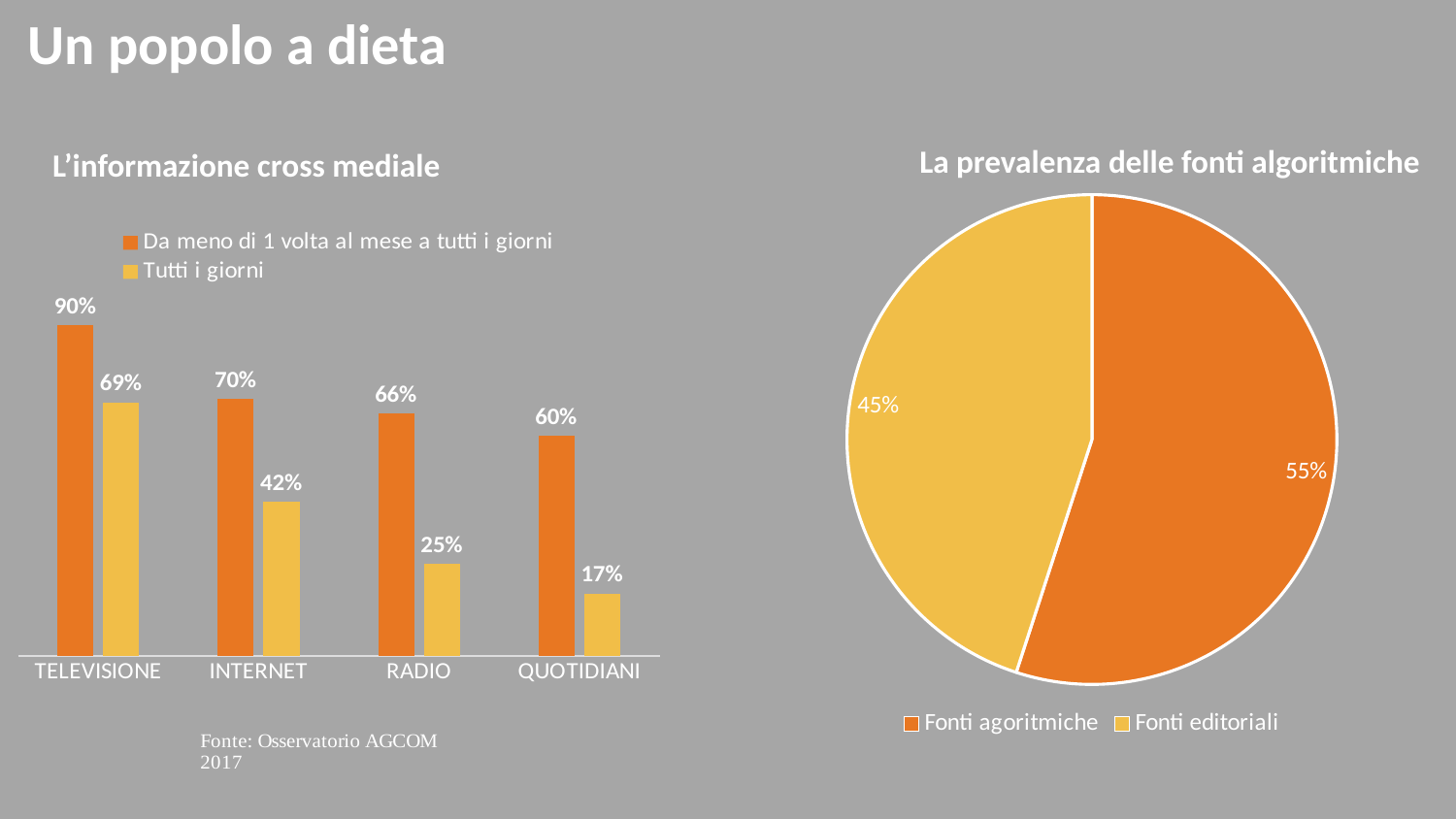
In the chart 'La prevalenza delle fonti algoritmiche', what share of the pie is 'Fonti agoritmiche'? 55% In the chart 'L'informazione cross mediale', which category has the lowest value in the series 'Tutti i giorni'? QUOTIDIANI In the chart 'L'informazione cross mediale', which is larger: the 'Tutti i giorni' value for INTERNET or for RADIO? INTERNET In the chart 'L'informazione cross mediale', what is the difference between the two series for INTERNET? 28% In the chart 'L'informazione cross mediale', what is the value for RADIO in the series 'Da meno di 1 volta al mese a tutti i giorni'? 66% What kind of chart is 'L'informazione cross mediale'? Bar chart How many series does the legend of the chart 'L'informazione cross mediale' list? 2 What kind of chart is 'La prevalenza delle fonti algoritmiche'? Pie chart In the chart 'L'informazione cross mediale', which category has the highest value in the series 'Da meno di 1 volta al mese a tutti i giorni'? TELEVISIONE In the chart 'La prevalenza delle fonti algoritmiche', which slice is larger: 'Fonti agoritmiche' or 'Fonti editoriali'? Fonti agoritmiche How many categories are shown on the x axis of the chart 'L'informazione cross mediale'? 4 In the chart 'L'informazione cross mediale', what is the value for TELEVISIONE in the series 'Tutti i giorni'? 69%